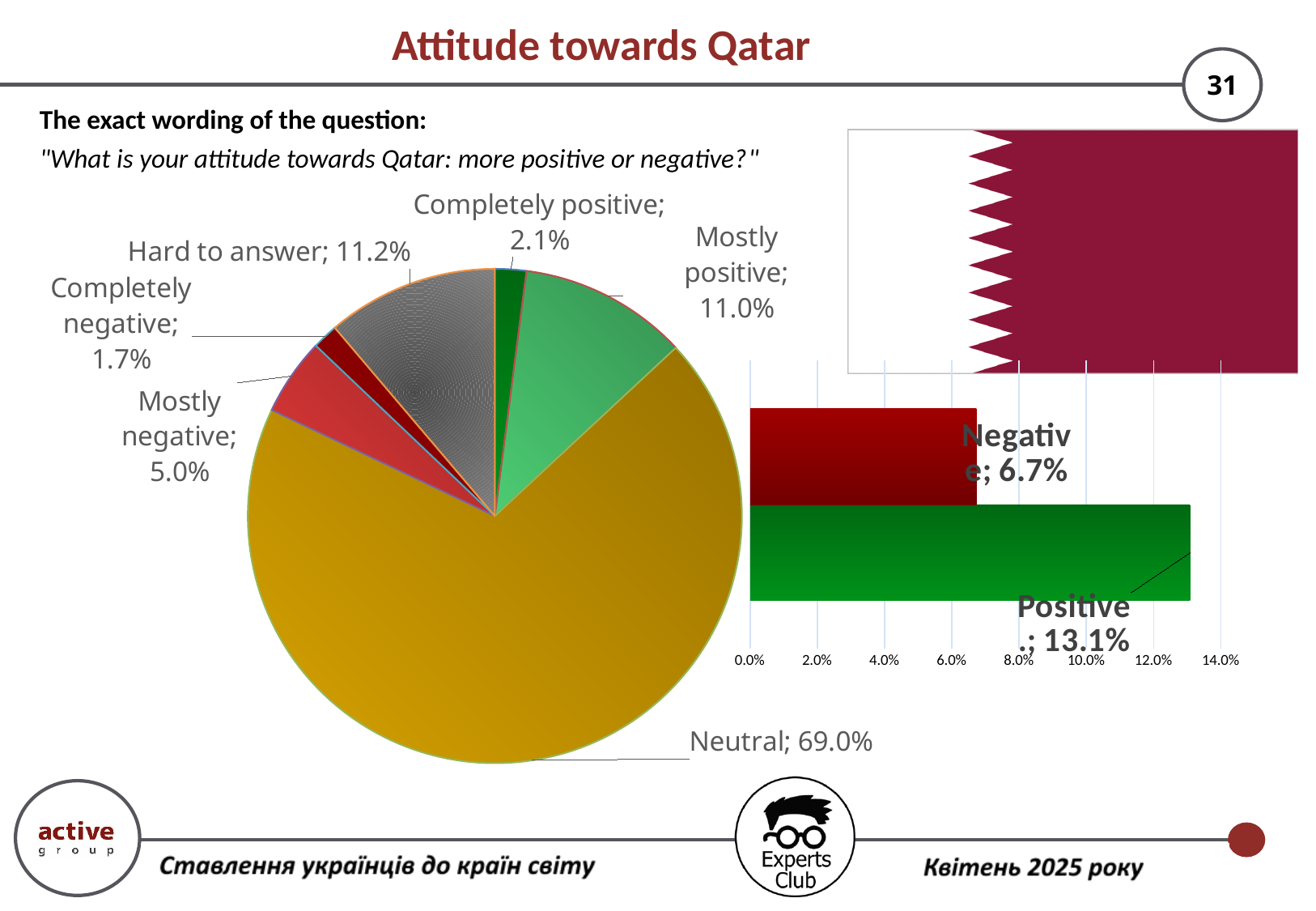
In the bar chart on the right, what is the value for Negative? 6.7% In the pie chart, how many categories are shown? 6 In the pie chart, which category has the largest share? Neutral In the pie chart, what share of respondents answered Neutral? 69.0% In the bar chart on the right, what is the value for Positive? 13.1% In the pie chart, which category has the smallest share? Completely negative In the pie chart, what is the value for Mostly positive? 11.0% In the pie chart, what is the difference between Mostly negative and Completely positive? 2.9% In the pie chart, what is the value for Completely negative? 1.7% In the pie chart, what is the value for Hard to answer? 11.2% In the bar chart on the right, what is the difference between Positive and Negative? 6.4% What kind of chart is shown on the right side of the slide? Bar chart